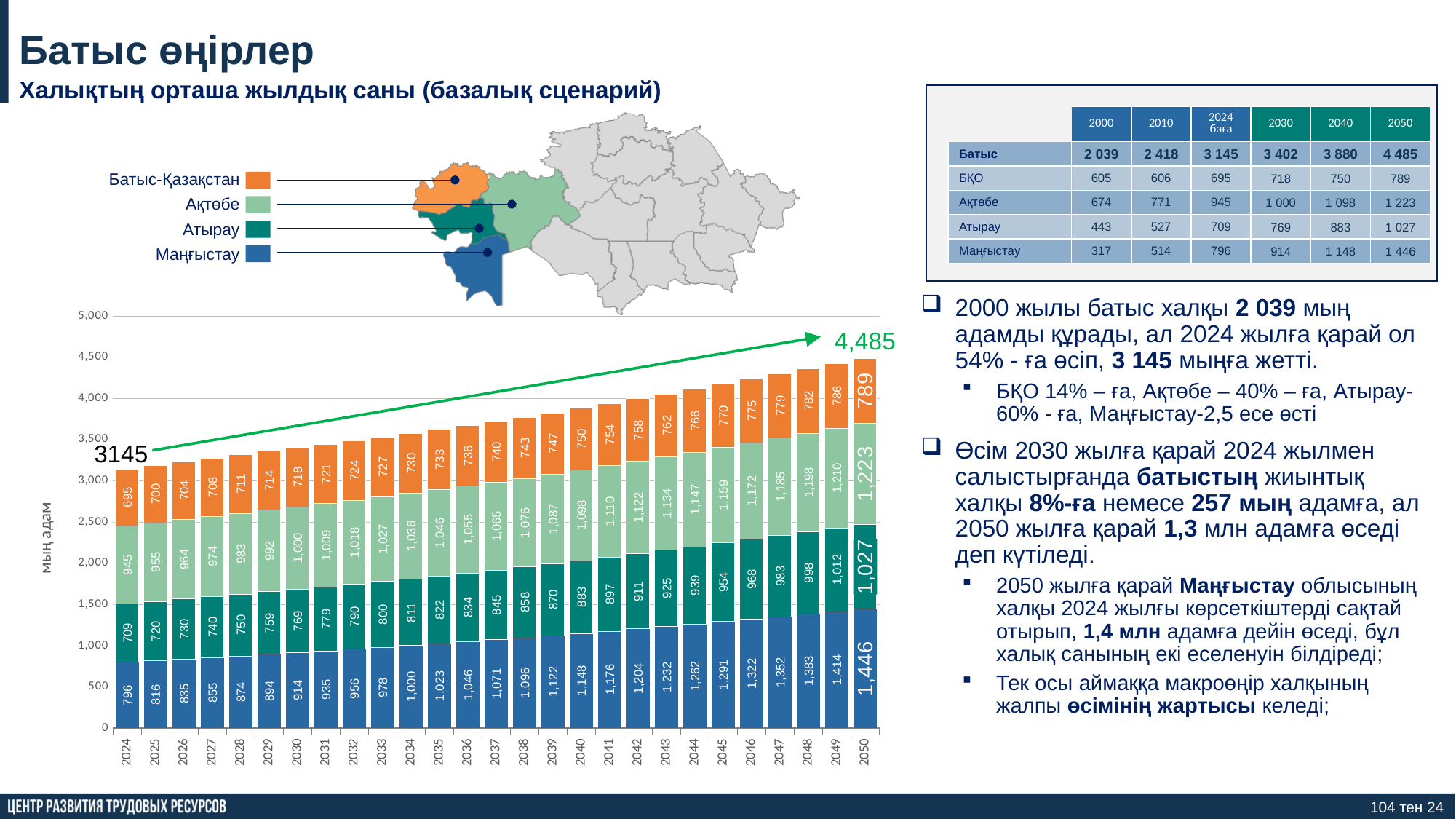
What is the total of the stacked bar for 2050? 4,485 What is the total of the stacked bar for 2024? 3145 How many series does the chart's legend list? 4 Which series has the largest value in 2050? Маңғыстау By how much does the value for Маңғыстау in 2050 exceed its value in 2024? 650 How many years are plotted along the x axis of the chart? 27 Do the total bar heights rise or fall from 2024 to 2050? Rise What is the value for Ақтөбе in 2050? 1,223 What kind of chart is shown on the slide? Stacked bar chart What is the value for Маңғыстау in 2024? 796 What is the value for Атырау in 2040? 883 Which series has the smallest value in 2024? Батыс-Қазақстан